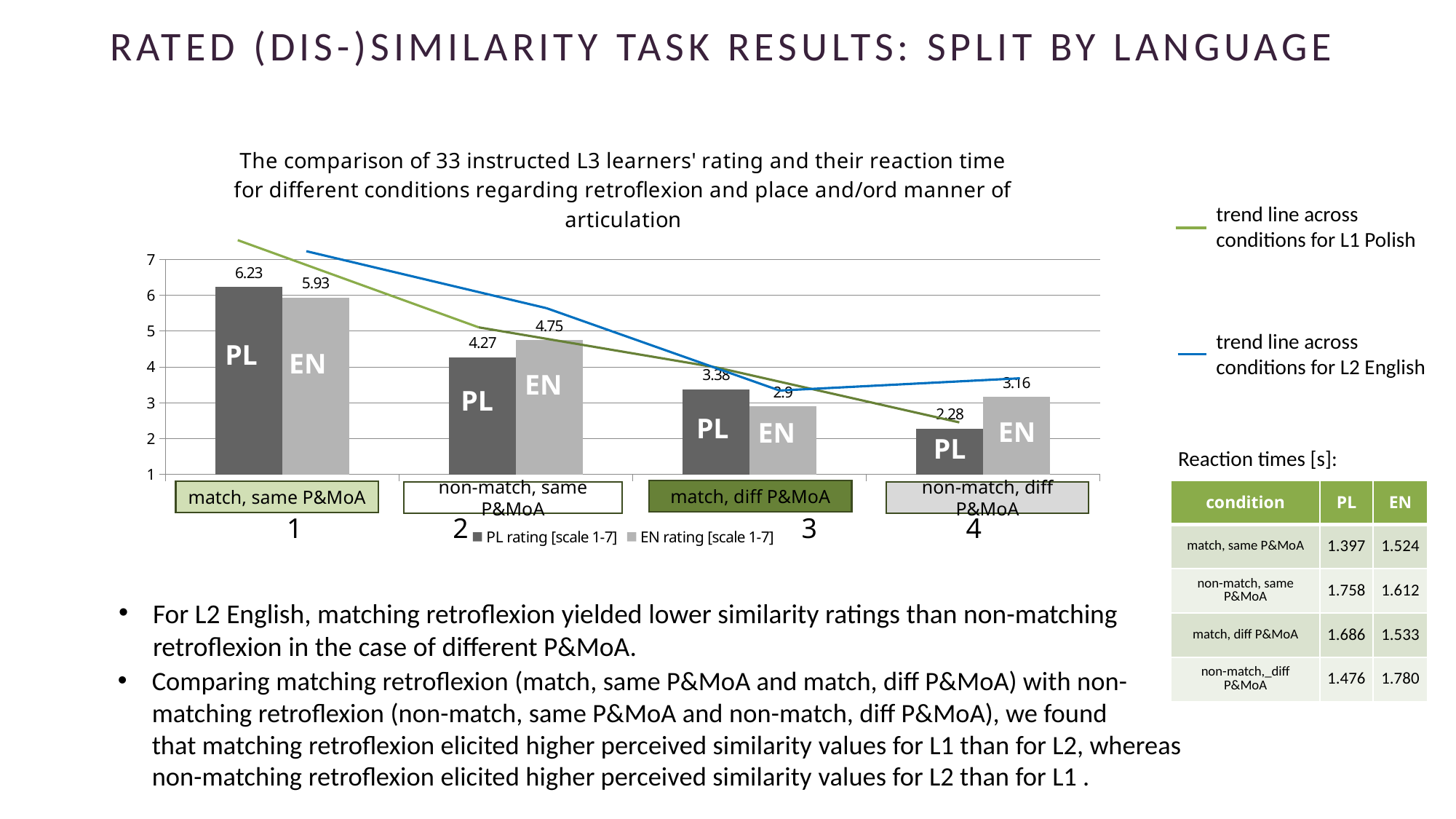
How many conditions are shown on the x axis of the chart? 4 Which condition has the lowest PL rating? non-match, diff P&MoA How many series does the chart legend list? 2 Which condition has the highest EN rating? match, same P&MoA Do the PL ratings rise or fall across the conditions from left to right? fall What kind of chart is used to show the ratings? bar chart What does the green line in the chart represent? trend line across conditions for L1 Polish What is the PL rating for the "match, same P&MoA" condition? 6.23 What is the EN rating for the "non-match, diff P&MoA" condition? 3.16 What is the difference between the PL and EN ratings for the "non-match, same P&MoA" condition? 0.48 What is the EN rating for the "match, diff P&MoA" condition? 2.9 For the "match, diff P&MoA" condition, which is larger, the PL rating or the EN rating? PL rating